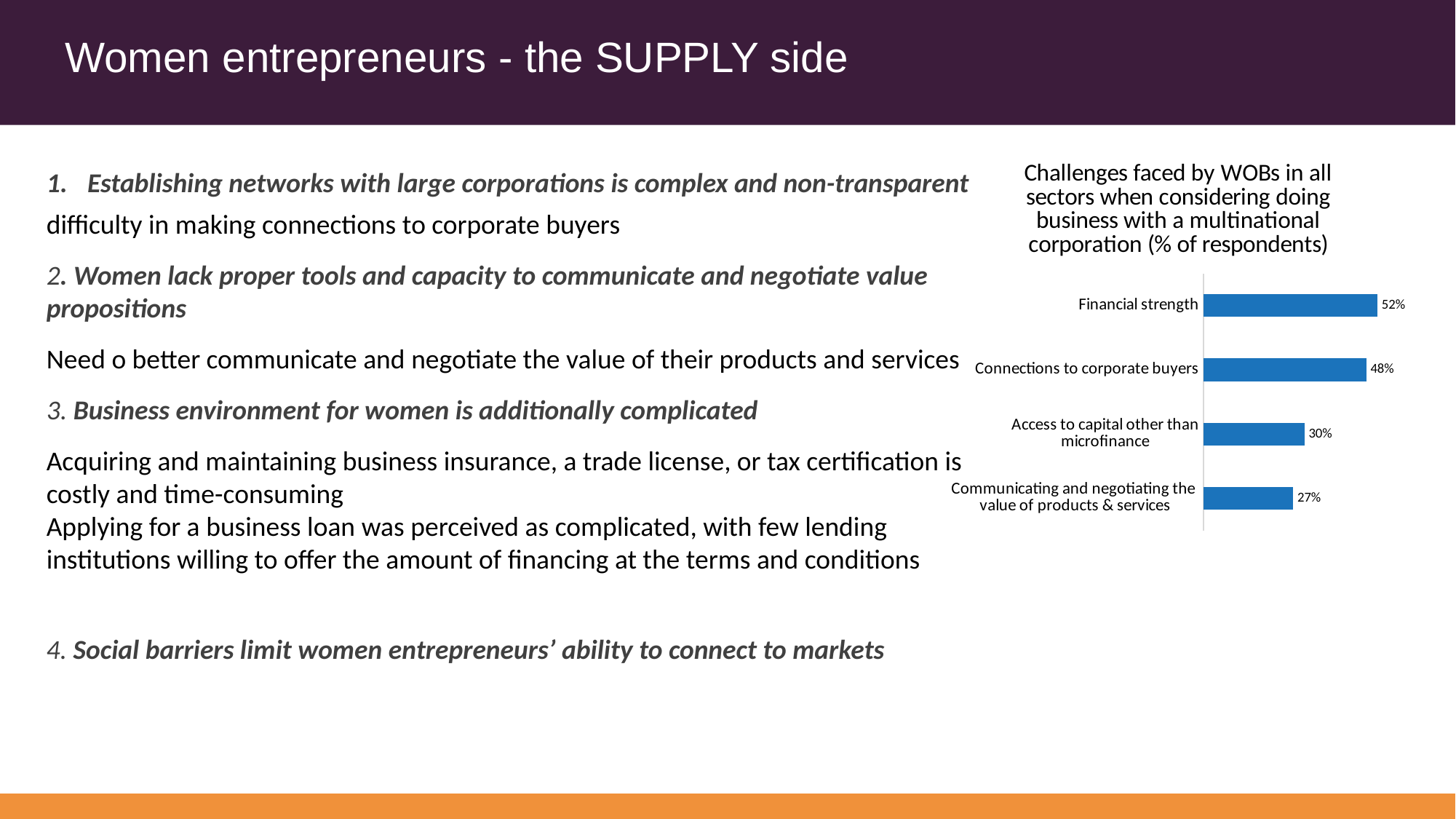
What kind of chart is shown on the slide? Bar chart Which is larger: the value for Connections to corporate buyers or the value for Access to capital other than microfinance? Connections to corporate buyers What percentage of respondents cited Financial strength as a challenge? 52% What is the value for Communicating and negotiating the value of products & services? 27% What is the difference between the values for Access to capital other than microfinance and Communicating and negotiating the value of products & services? 3% What is the value for Connections to corporate buyers? 48% What is the value for Access to capital other than microfinance? 30% How many challenge categories are shown in the chart? 4 Which challenge has the highest percentage of respondents? Financial strength What is the title of the chart? Challenges faced by WOBs in all sectors when considering doing business with a multinational corporation (% of respondents) What is the difference between the values for Financial strength and Connections to corporate buyers? 4% Which challenge has the lowest percentage of respondents? Communicating and negotiating the value of products & services